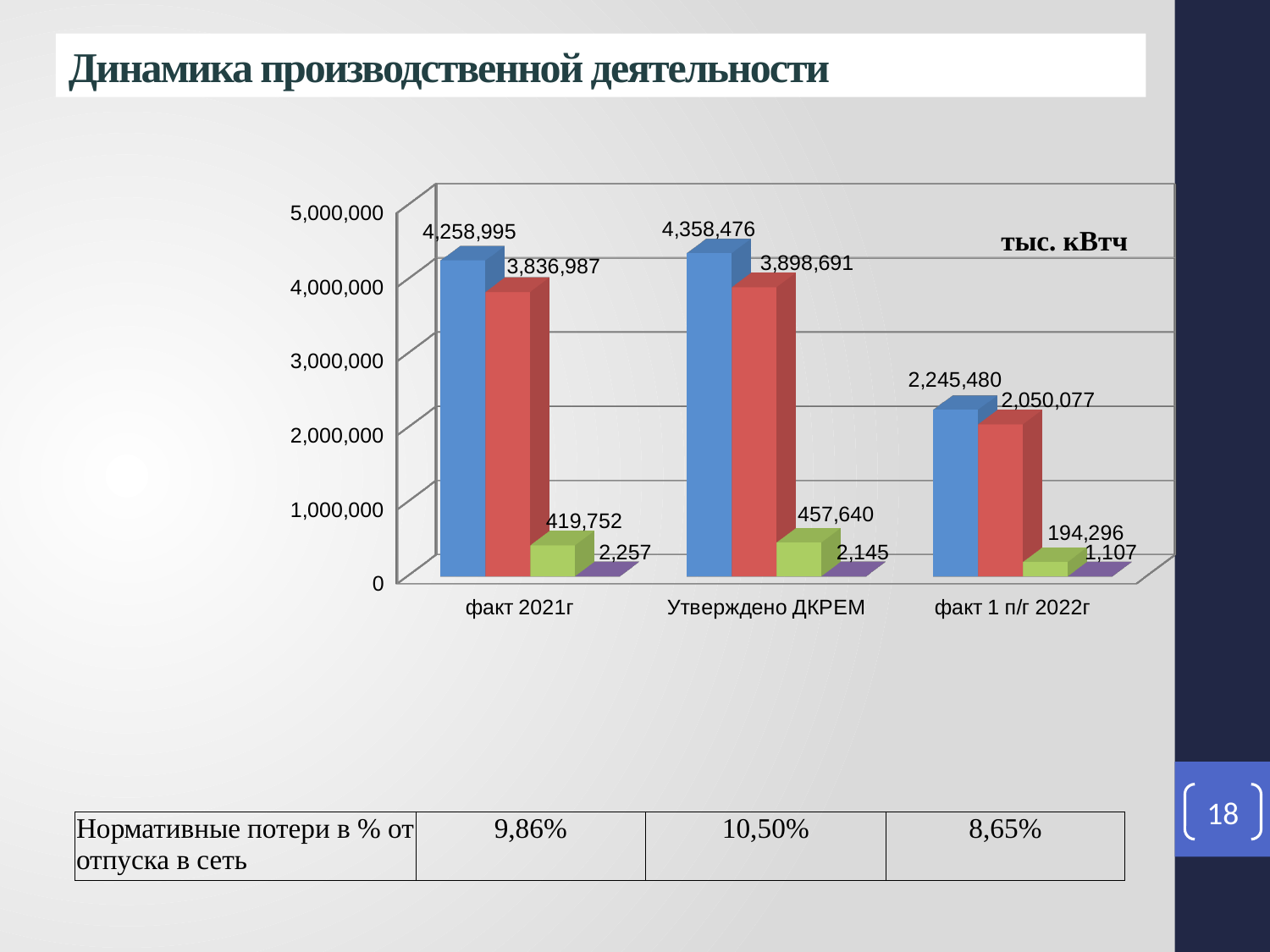
Which category has the lowest red bar? факт 1 п/г 2022г Is the value of the red bar for факт 1 п/г 2022г greater or less than 3,000,000? less How many categories are shown on the x axis? 3 What is the value of the red bar for Утверждено ДКРЕМ? 3,898,691 What is the value of the green bar for факт 1 п/г 2022г? 194,296 What is the value of the blue bar for факт 2021г? 4,258,995 What unit is shown in the label inside the chart area? тыс. кВтч What type of chart is shown on the slide? bar chart Which category has the highest blue bar? Утверждено ДКРЕМ What is the value of the purple bar for факт 2021г? 2,257 Which is larger: the green bar for факт 2021г or the green bar for Утверждено ДКРЕМ? Утверждено ДКРЕМ What is the difference between the blue bars for Утверждено ДКРЕМ and факт 2021г? 99,481